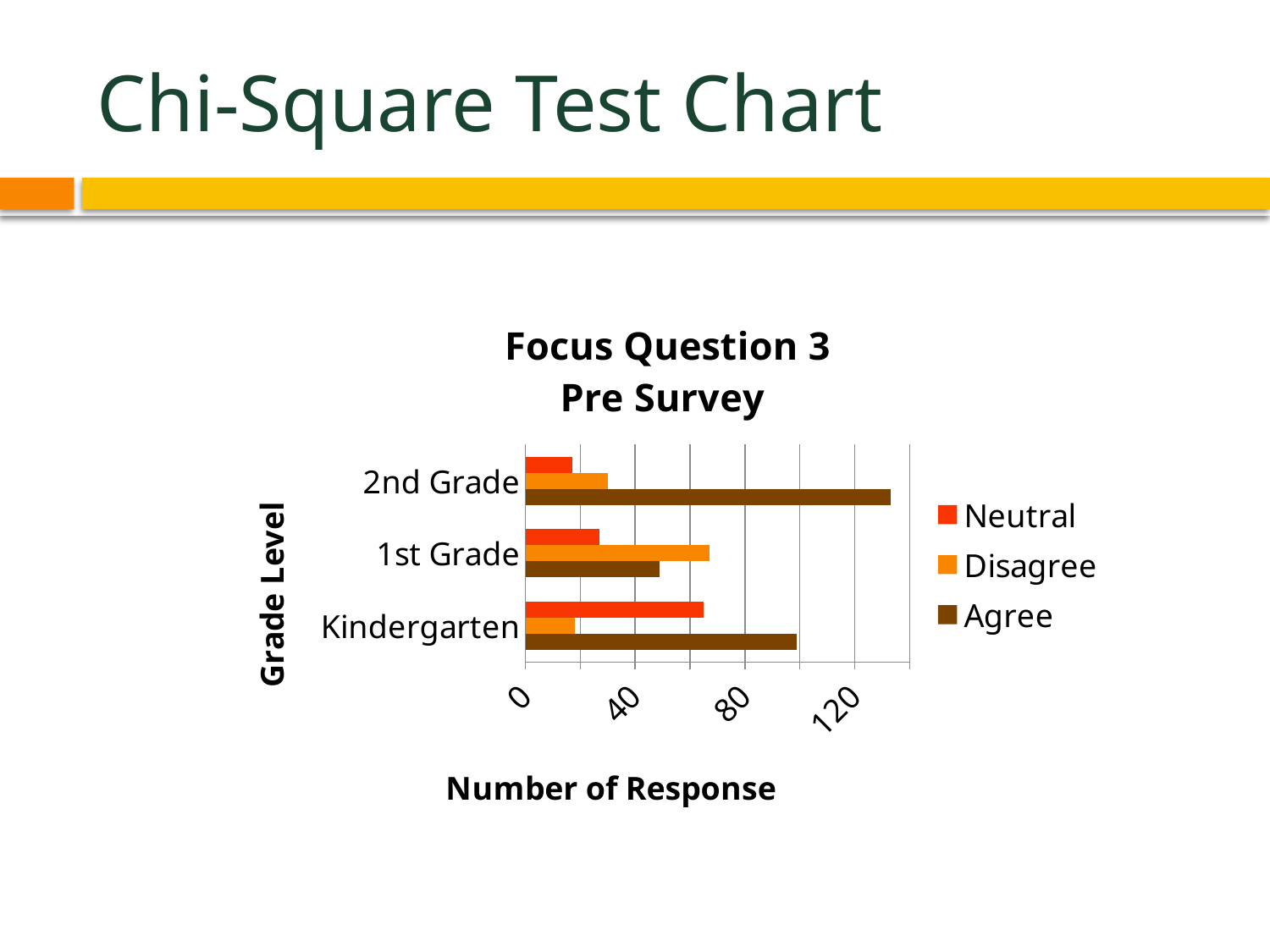
Which is larger for 1st Grade, the Disagree value or the Agree value? Disagree Is the Neutral value for Kindergarten greater or less than 40? greater How many series does the chart legend list? 3 What is the label of the horizontal axis of the chart? Number of Response Which grade level has the shortest Agree bar? 1st Grade Which grade level has the longest Agree bar? 2nd Grade Is the Agree value for Kindergarten greater or less than 80? greater Is the Neutral value for 2nd Grade greater or less than 40? less How many grade levels are shown on the chart? 3 What kind of chart is shown on the slide? Bar chart Which is larger for Kindergarten, the Neutral value or the Disagree value? Neutral